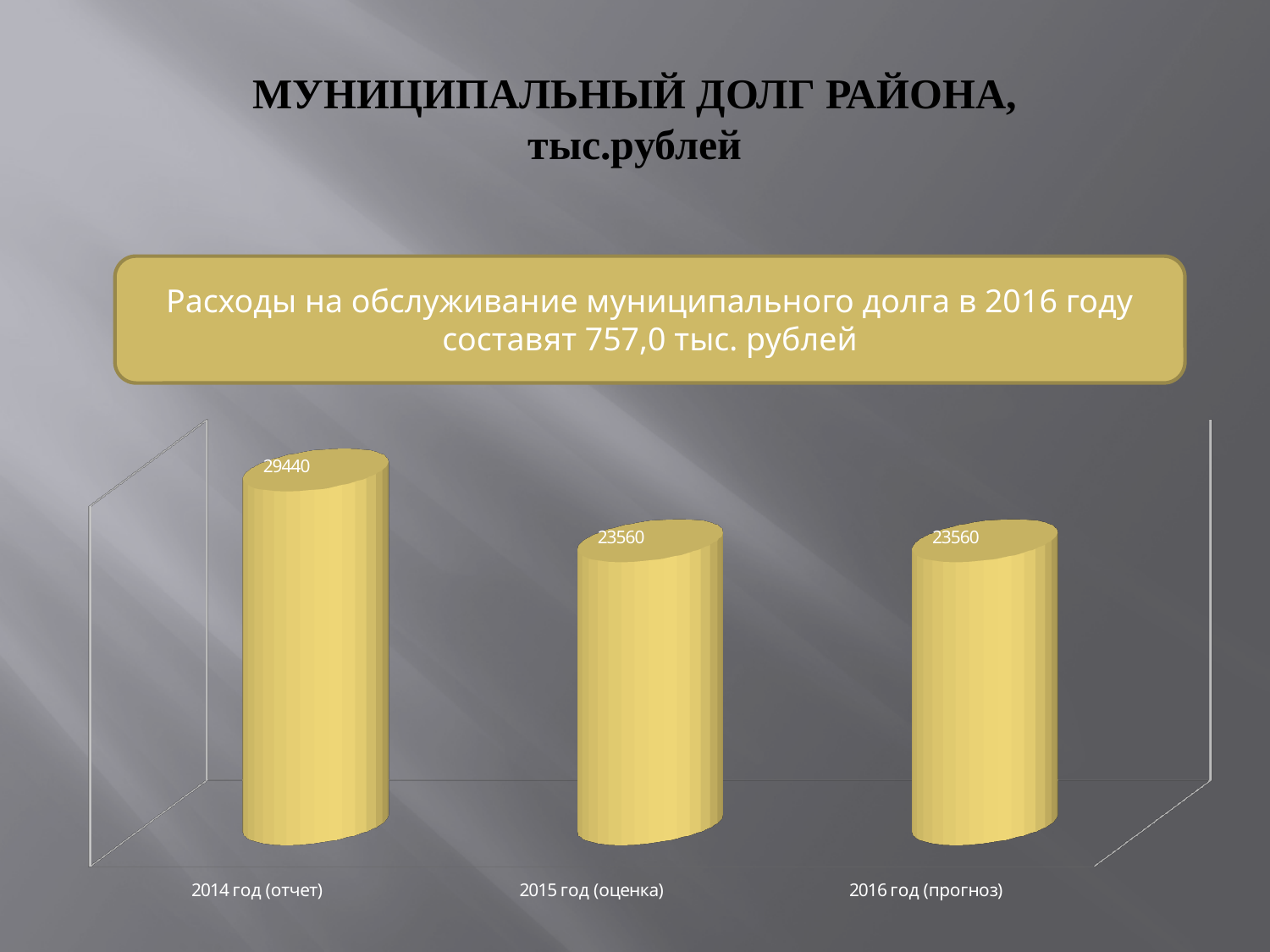
Which is larger, the value for 2014 год (отчет) or the value for 2016 год (прогноз)? 2014 год (отчет) What colour are the bars in the chart? yellow What is the value for 2014 год (отчет)? 29440 Which category has the highest value? 2014 год (отчет) What is the difference between the values for 2014 год (отчет) and 2015 год (оценка)? 5880 What is the value for 2015 год (оценка)? 23560 Does the value change between 2015 год (оценка) and 2016 год (прогноз)? No, it stays at 23560 What is the value for 2016 год (прогноз)? 23560 Does the value rise or fall from 2014 год (отчет) to 2015 год (оценка)? fall What kind of chart is shown on the slide? bar chart How many categories are shown in the chart? 3 What is the title of the slide containing the chart? МУНИЦИПАЛЬНЫЙ ДОЛГ РАЙОНА, тыс.рублей